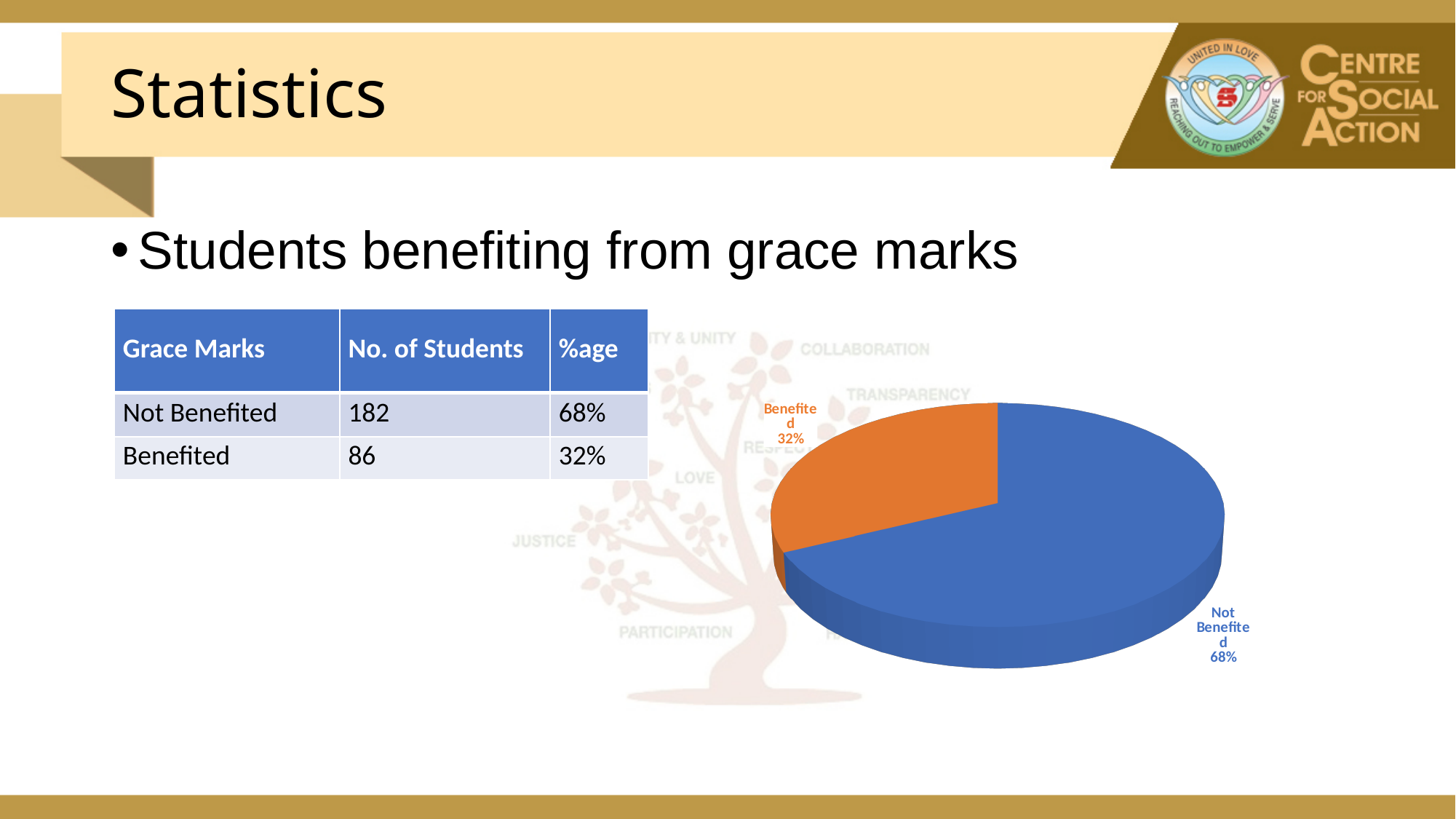
Which is larger in the pie chart, Benefited or Not Benefited? Not Benefited What is the difference in percentage points between the Not Benefited and Benefited slices? 36% How many slices does the pie chart have? 2 What colour is the Not Benefited slice in the pie chart? Blue What colour is the Benefited slice in the pie chart? Orange Which slice of the pie chart is the smallest? Benefited What kind of chart is shown on the slide? Pie chart What share of the pie does the Benefited slice represent? 32% What share of the pie does the Not Benefited slice represent? 68% Which slice of the pie chart is the largest? Not Benefited